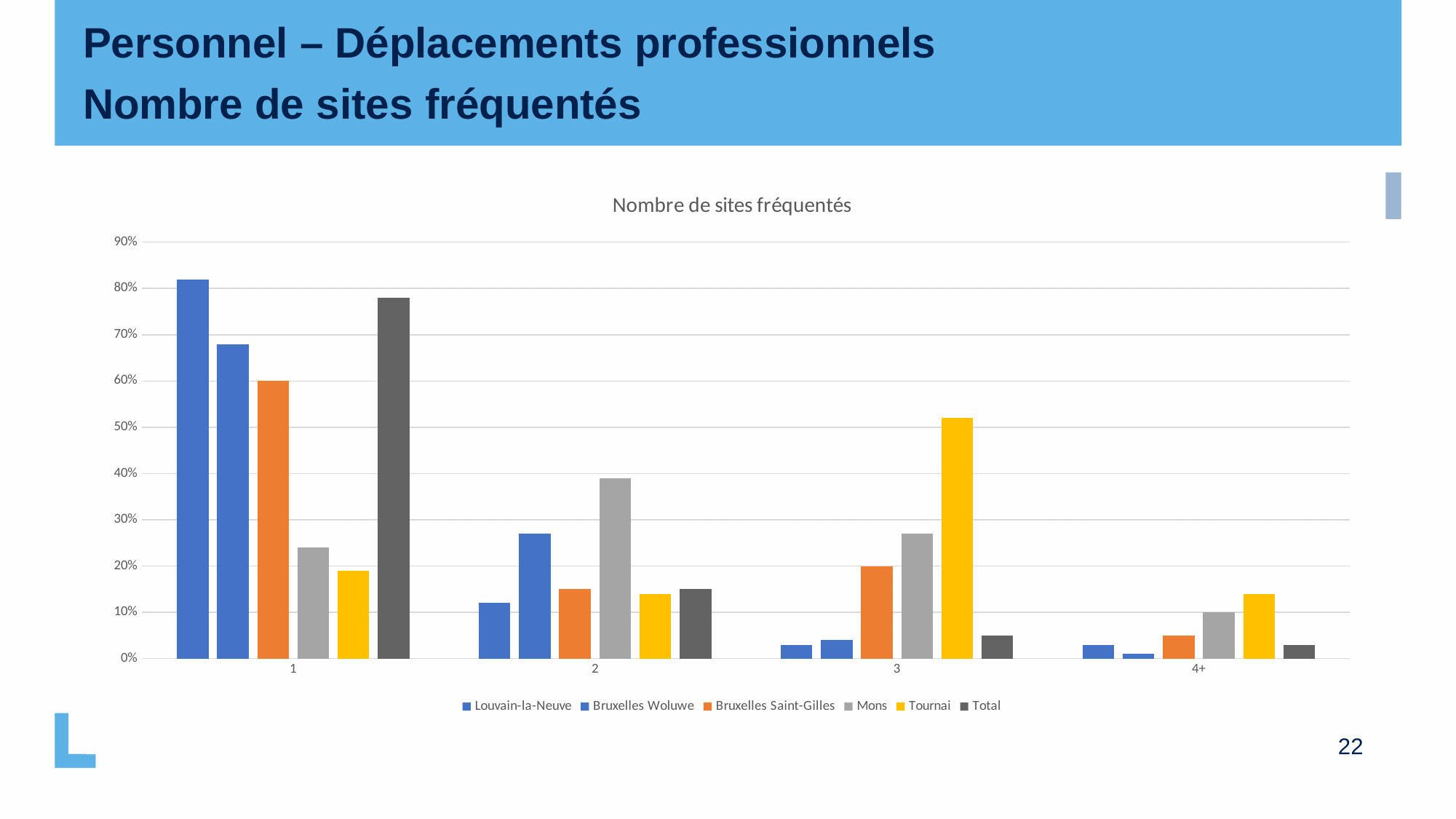
Is the value for Total in category 1 greater or less than 70%? greater Is the value for Mons in category 2 greater or less than 30%? greater Is the value for Tournai in category 3 greater or less than 40%? greater Does the Total series rise or fall from category 1 to category 4+? fall In category 1, which series has the highest bar? Louvain-la-Neuve In category 1, which is larger: Bruxelles Saint-Gilles or Mons? Bruxelles Saint-Gilles How many series does the legend list? 6 How many categories are shown on the x axis? 4 In category 3, which series has the highest bar? Tournai In category 2, which series has the highest bar? Mons What is the title of the chart? Nombre de sites fréquentés What kind of chart is shown on the slide? bar chart